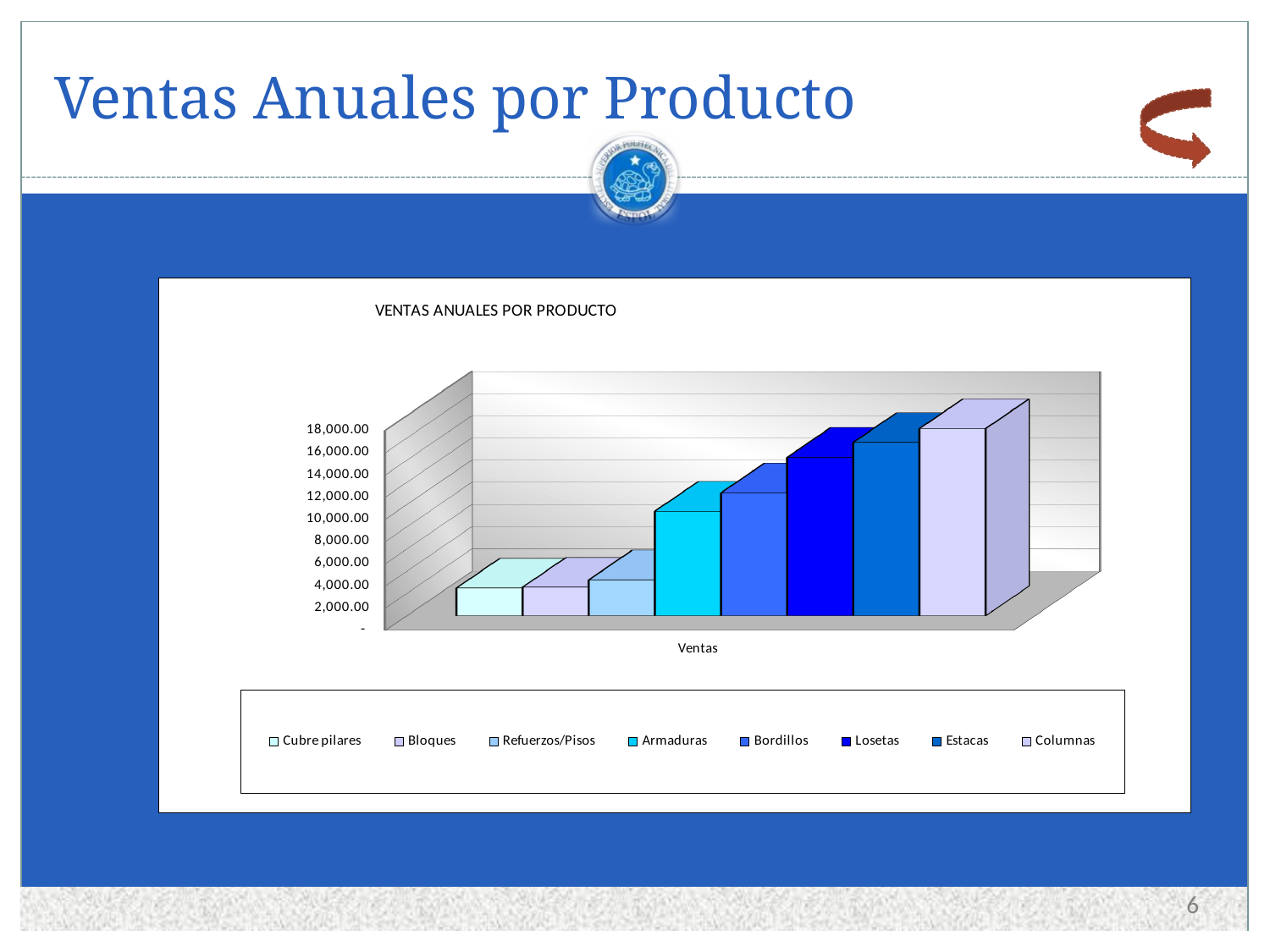
What is the label of the category on the x axis? Ventas Do the bar heights rise or fall from left to right across the products? rise Which is larger, the value for Estacas or the value for Bordillos? Estacas How many categories are shown on the x axis? 1 What kind of chart is shown on the slide? Bar chart Is the value for Armaduras greater or less than 6,000.00? greater Is the value for Columnas greater or less than 14,000.00? greater Is the value for Cubre pilares greater or less than 8,000.00? less Which product has the highest sales value? Columnas What is the title of the chart? VENTAS ANUALES POR PRODUCTO How many series does the legend list? 8